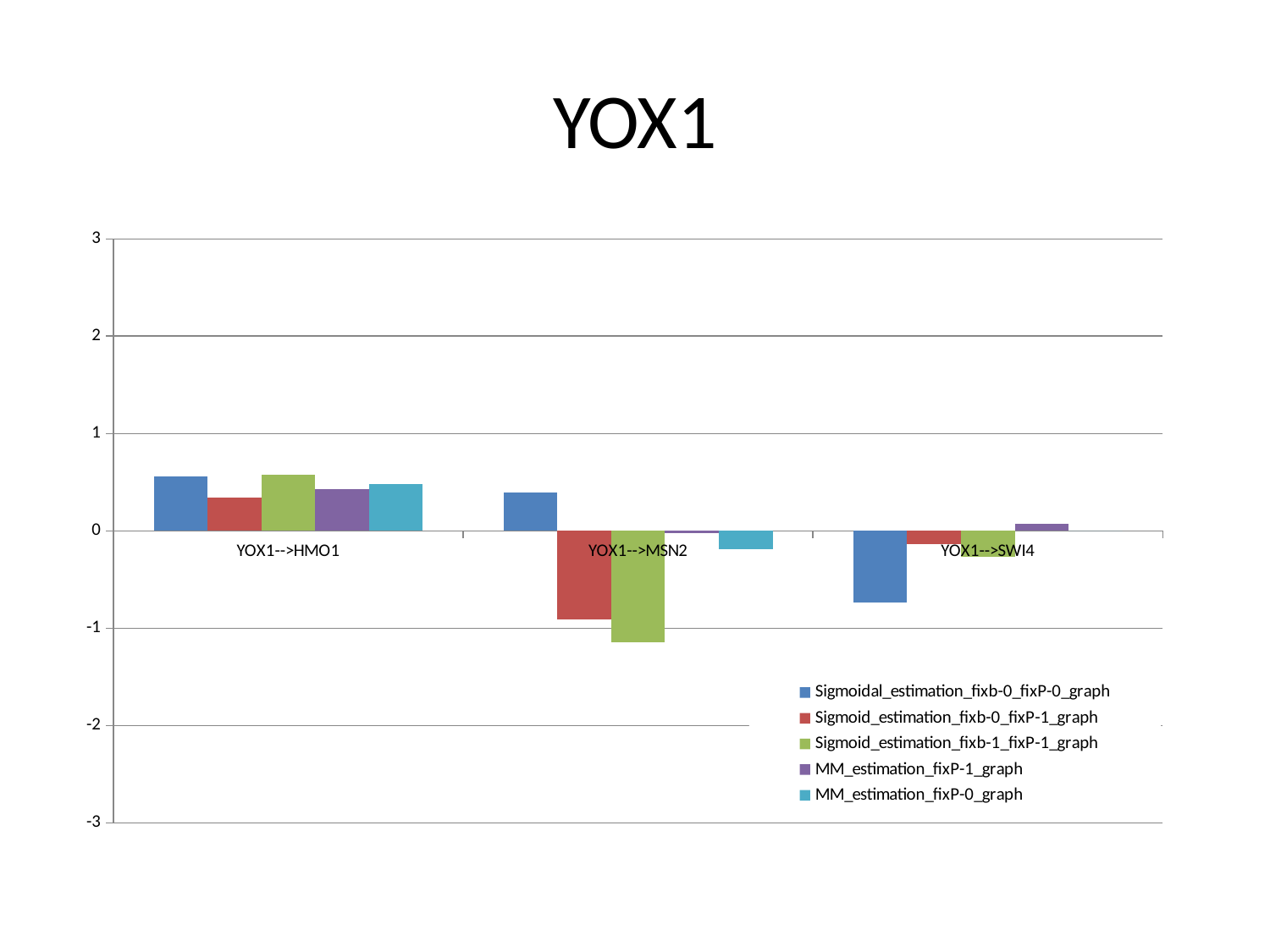
How many series does the legend list? 5 Is the value for Sigmoid_estimation_fixb-1_fixP-1_graph at YOX1-->MSN2 greater or less than -1? less Is the value for Sigmoid_estimation_fixb-0_fixP-1_graph at YOX1-->HMO1 greater or less than 1? less What kind of chart is shown on the slide? Bar chart Which category has the lowest value for Sigmoid_estimation_fixb-1_fixP-1_graph? YOX1-->MSN2 Which category has the highest value for Sigmoidal_estimation_fixb-0_fixP-0_graph? YOX1-->HMO1 Do the values for Sigmoidal_estimation_fixb-0_fixP-0_graph rise or fall from YOX1-->HMO1 to YOX1-->SWI4? fall What is the title of the chart? YOX1 At YOX1-->MSN2, which is larger: Sigmoidal_estimation_fixb-0_fixP-0_graph or Sigmoid_estimation_fixb-1_fixP-1_graph? Sigmoidal_estimation_fixb-0_fixP-0_graph Is the value for Sigmoidal_estimation_fixb-0_fixP-0_graph at YOX1-->SWI4 greater or less than 0? less How many categories are shown on the x axis? 3 Which series is shown in light blue (cyan) in the legend? MM_estimation_fixP-0_graph